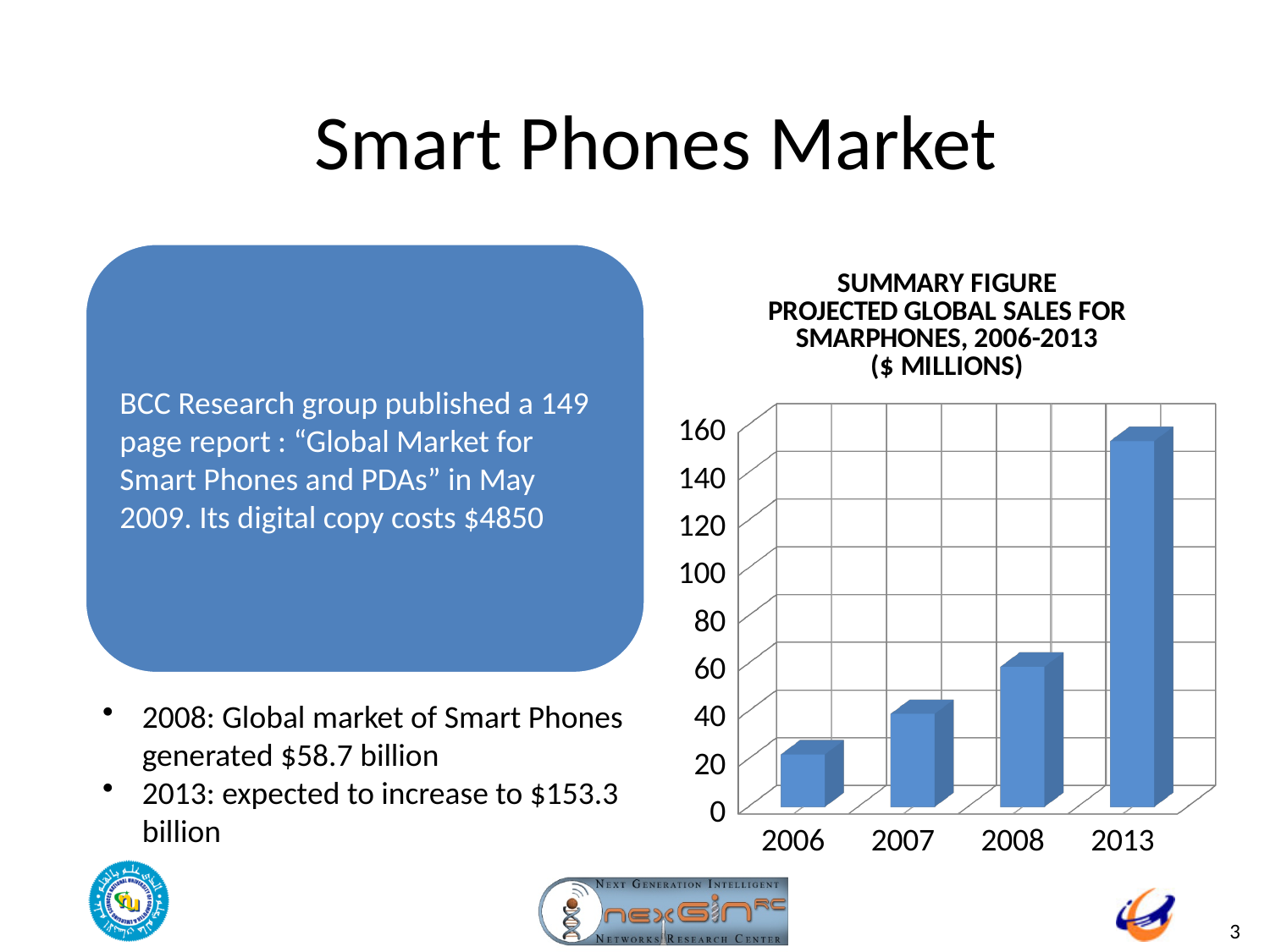
How many years are plotted on the x axis of the chart? 4 What kind of chart is shown on the slide? bar chart Which year has the highest bar in the chart? 2013 Is the value for 2006 greater or less than 40? less Is the value for 2013 greater or less than 140? greater Which year has the lowest bar in the chart? 2006 Do the values rise or fall from 2006 to 2013 along the x axis? rise Is the value for 2008 greater or less than 40? greater Which is larger, the value for 2007 or the value for 2008? 2008 What unit is stated in the chart title? $ millions What is the highest value shown on the chart's vertical axis? 160